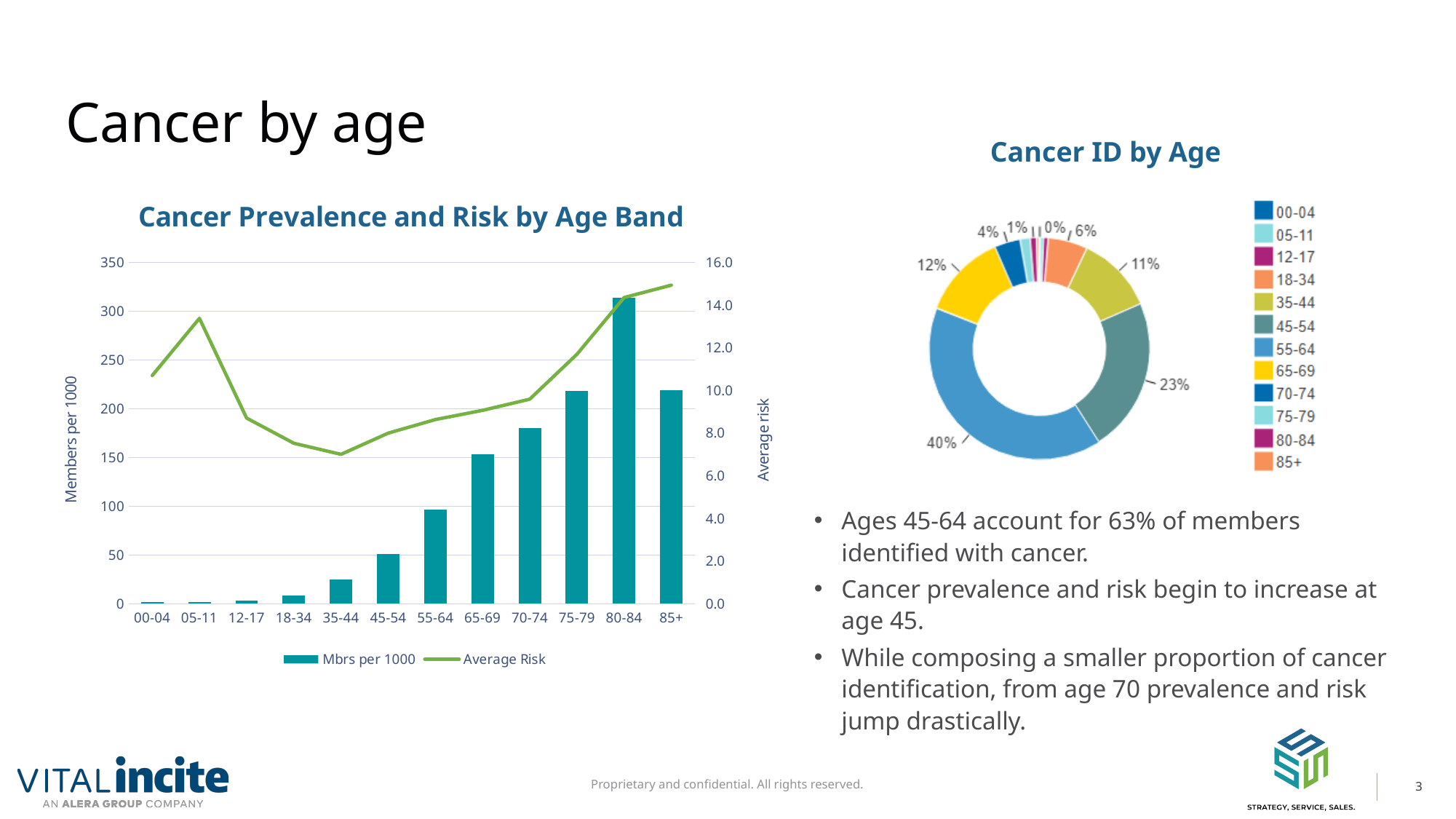
In the Cancer Prevalence and Risk by Age Band chart, do the Mbrs per 1000 bars generally rise or fall from 00-04 to 80-84? rise In the Cancer Prevalence and Risk by Age Band chart, how many series does the legend list? 2 In the Cancer ID by Age chart, which age band has the largest slice? 55-64 In the Cancer Prevalence and Risk by Age Band chart, what kind of chart is used to show Mbrs per 1000? bar chart In the Cancer ID by Age chart, what share of the donut is the 55-64 age band? 40% In the Cancer ID by Age chart, what is the difference between the 55-64 share and the 45-54 share? 17% In the Cancer Prevalence and Risk by Age Band chart, how many age bands are shown on the x axis? 12 In the Cancer Prevalence and Risk by Age Band chart, which age band has the highest Mbrs per 1000 bar? 80-84 In the Cancer Prevalence and Risk by Age Band chart, is the Mbrs per 1000 value for 45-54 greater or less than 100? less In the Cancer Prevalence and Risk by Age Band chart, is the Mbrs per 1000 value for 80-84 greater or less than 300? greater In the Cancer Prevalence and Risk by Age Band chart, is the Average Risk for 85+ greater or less than 14.0? greater In the Cancer Prevalence and Risk by Age Band chart, which age band has the lowest Average Risk? 35-44